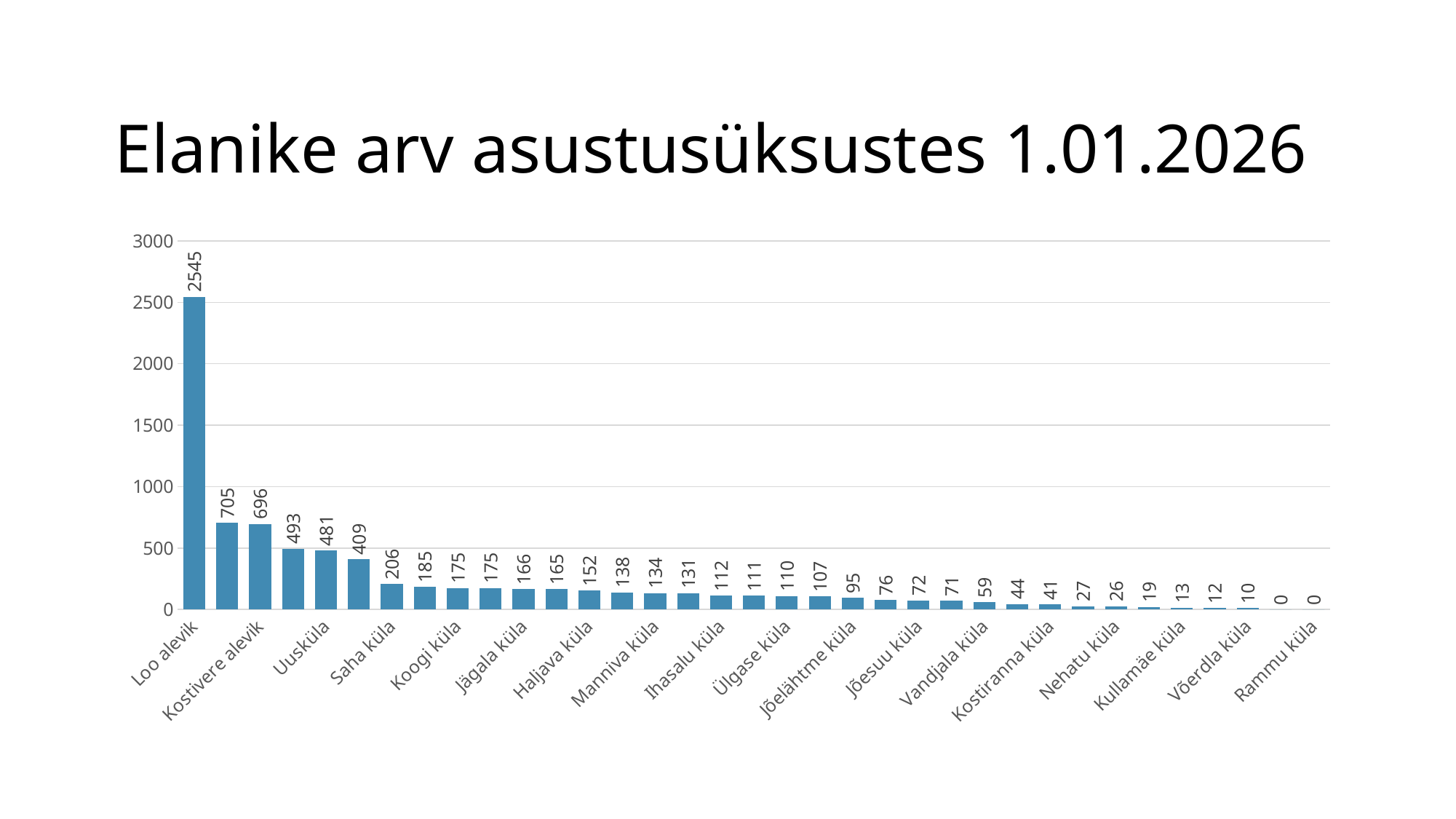
What kind of chart is shown on the slide? bar chart What is the value for Kostivere alevik? 696 Do the values rise or fall from left to right along the x axis? fall What is the difference between the values for Loo alevik and Kostivere alevik? 1849 What is the value for Loo alevik? 2545 Is the value for Uusküla greater or less than 500? less Which is larger, the value for Saha küla or the value for Koogi küla? Saha küla Which category has the highest value? Loo alevik What is the value for Saha küla? 206 What is the value for Jõelähtme küla? 95 What is the value for Rammu küla? 0 What is the title of the chart? Elanike arv asustusüksustes 1.01.2026